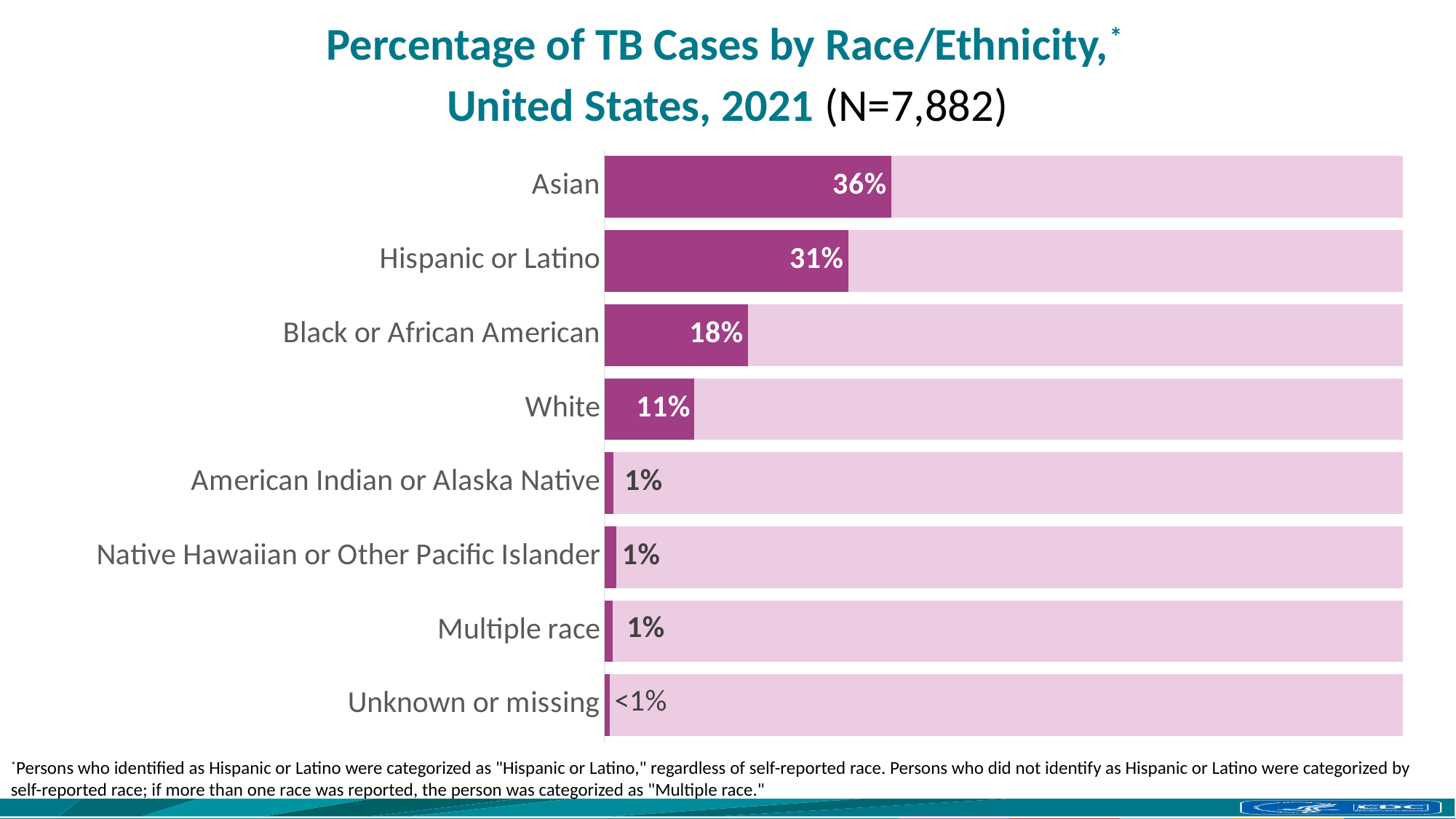
How many race/ethnicity categories are shown in the chart? 8 What percentage of TB cases were among Hispanic or Latino persons? 31% What value is shown for Unknown or missing? <1% What is the difference in percentage points between Asian and Hispanic or Latino? 5% What is the total number of TB cases (N) given in the chart title? 7,882 What percentage of TB cases were among Asian persons? 36% What percentage of TB cases were among Black or African American persons? 18% What is the difference in percentage points between Black or African American and White? 7% Which is larger, the percentage for Hispanic or Latino or for Black or African American? Hispanic or Latino What percentage of TB cases were among White persons? 11% Which race/ethnicity category has the highest percentage of TB cases? Asian What kind of chart is shown on the slide? Bar chart